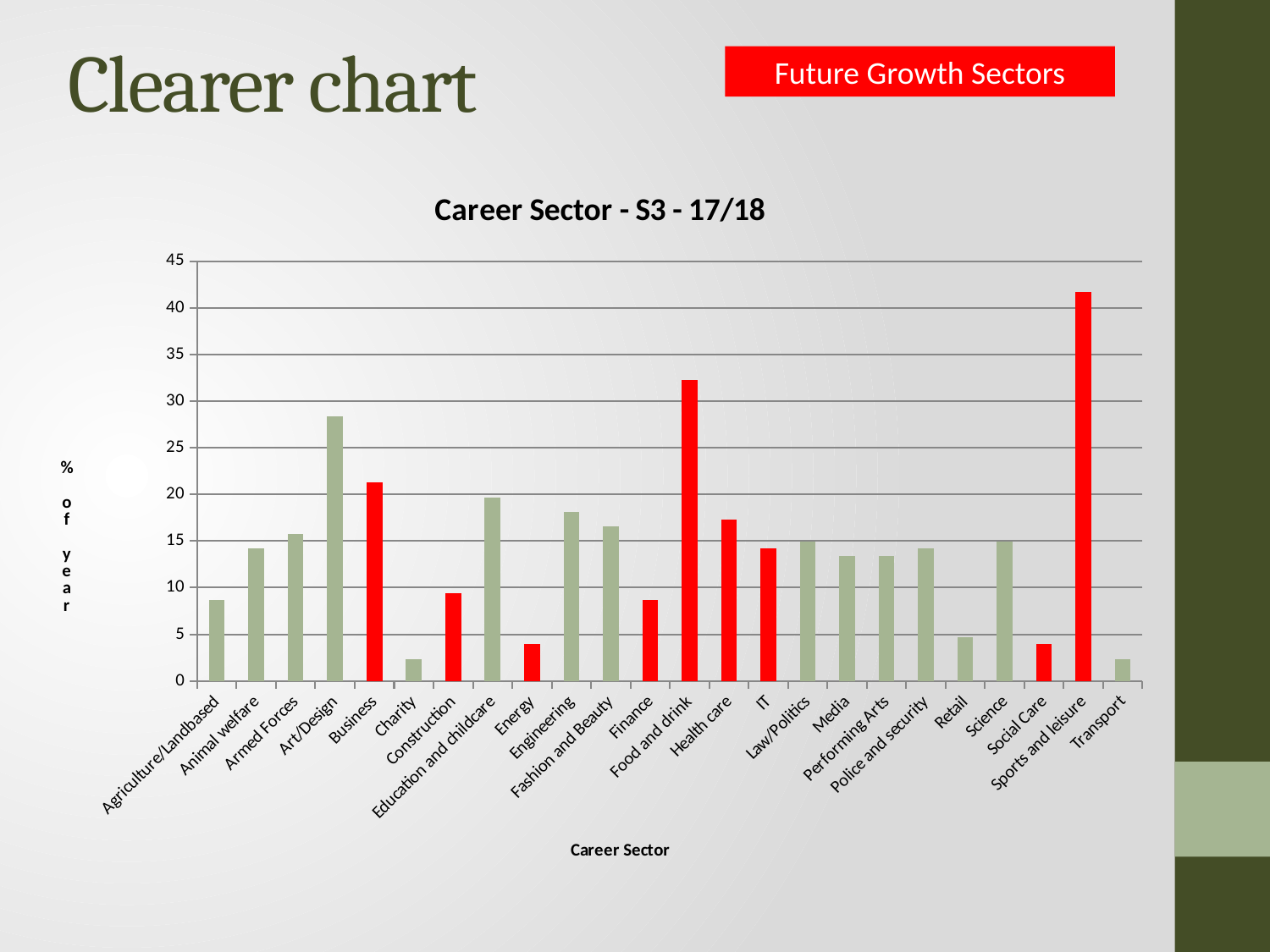
How many career sector categories are plotted on the x axis? 24 Is the value for Food and drink greater or less than 30? greater Is the value for Sports and leisure greater or less than 40? greater Which career sector has the highest value? Sports and leisure Is the value for Finance greater or less than 10? less Which is larger, the value for Food and drink or the value for Art/Design? Food and drink What kind of chart is shown on the slide? bar chart What is the title of the chart? Career Sector - S3 - 17/18 Which is larger, the value for Business or the value for Construction? Business What is the title of the x axis? Career Sector